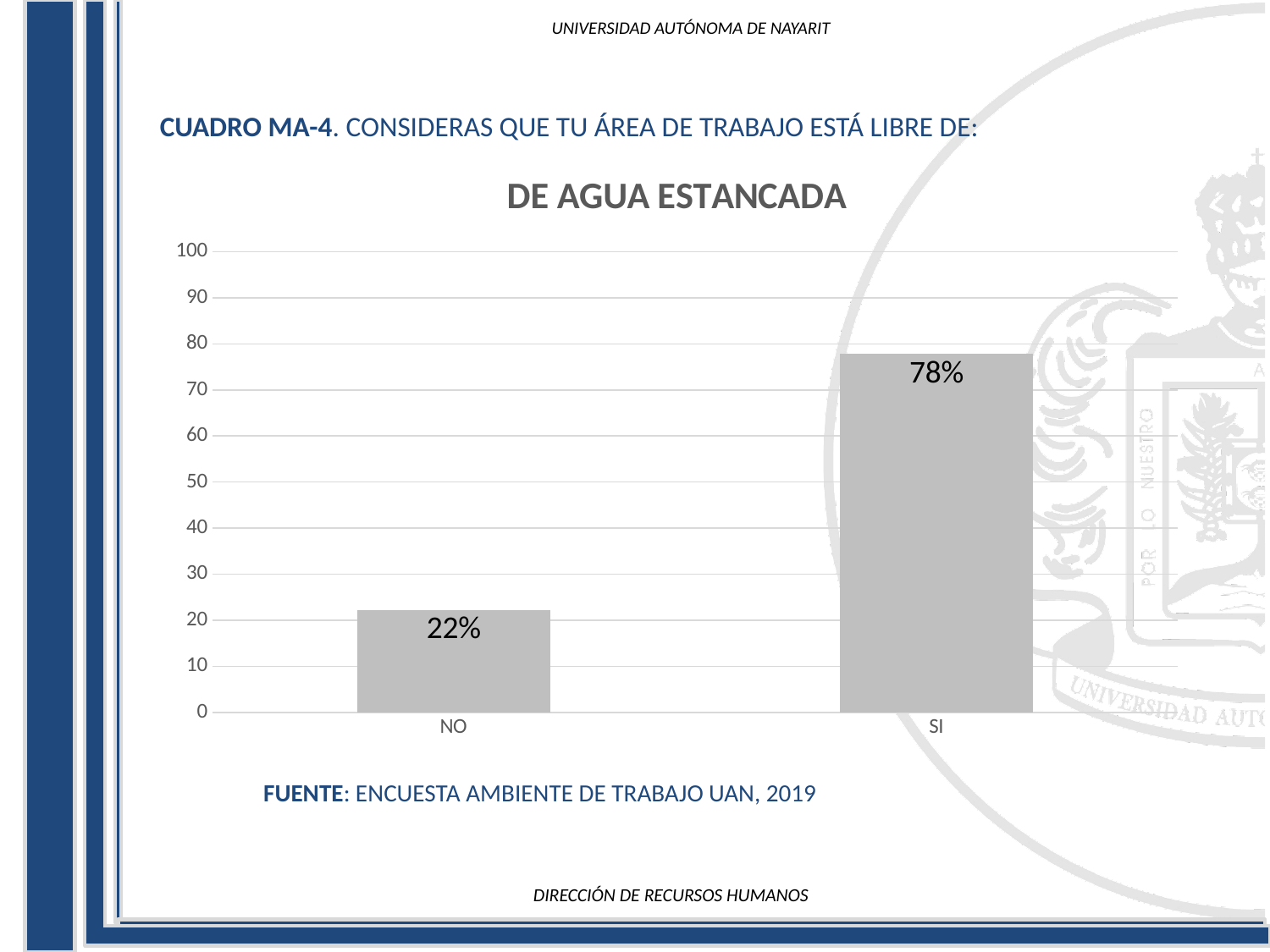
What kind of chart is shown? bar chart Which category has the highest value? SI Is the value for NO greater or less than 30? less Which category has the lowest value? NO Which is larger, the value for NO or the value for SI? SI Is the value for SI greater or less than 70? greater What is the highest value shown on the y axis? 100 What is the value for SI? 78% What is the difference between the values for SI and NO? 56% What is the title of the chart? DE AGUA ESTANCADA How many categories are shown on the x axis? 2 What is the value for NO? 22%